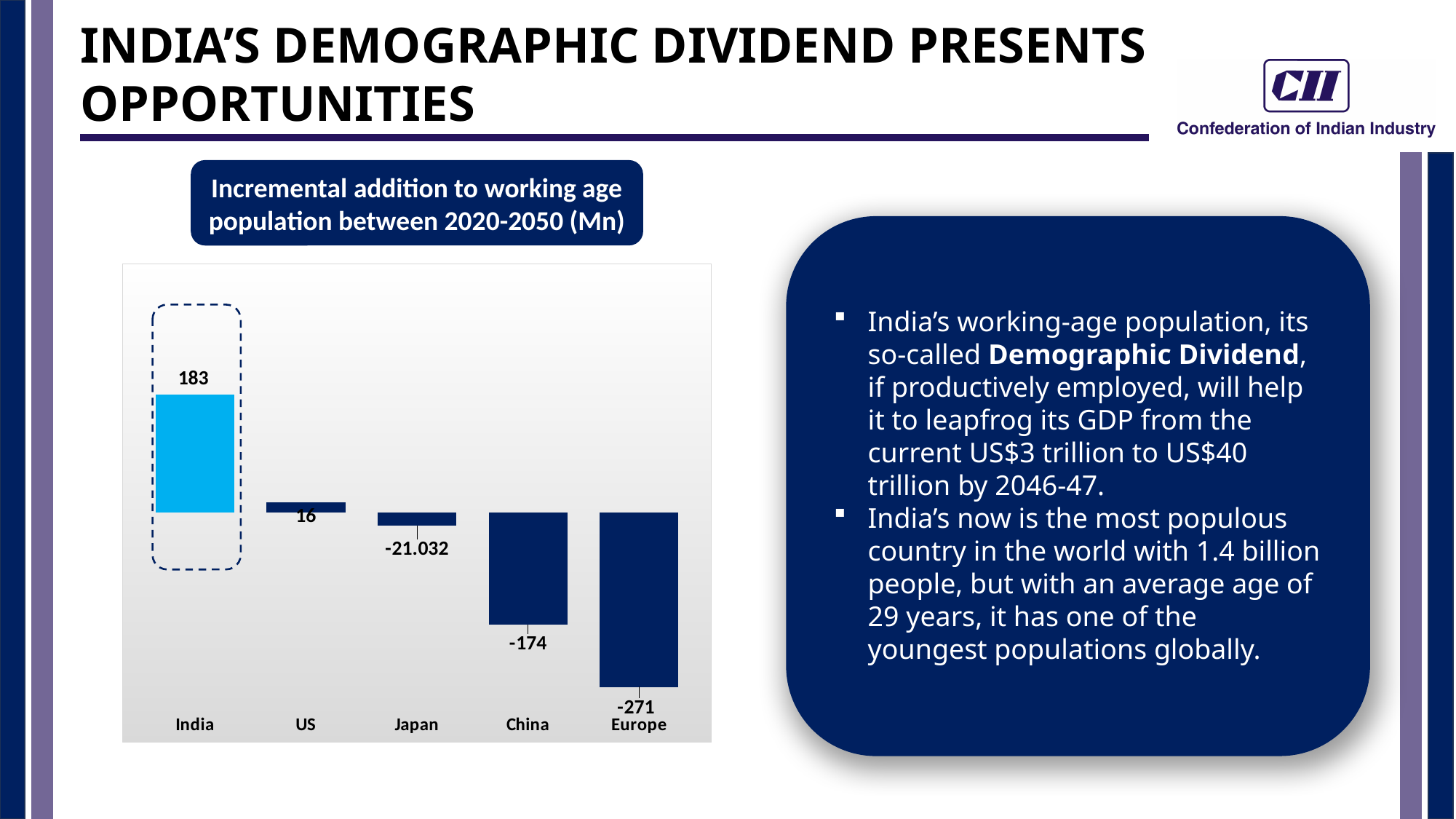
How many countries or regions are shown on the chart? 5 What is the title of the chart? Incremental addition to working age population between 2020-2050 (Mn) What is the value shown for Japan? -21.032 Which has a larger value, China or Japan? Japan What is the value shown for Europe? -271 What kind of chart is shown on the slide? Bar chart Which category has the lowest value? Europe What is the incremental addition to working age population for India? 183 Which category has the highest value? India What is the difference between the values for India and the US? 167 What is the difference between the values for China and Europe? 97 What is the value shown for the US? 16